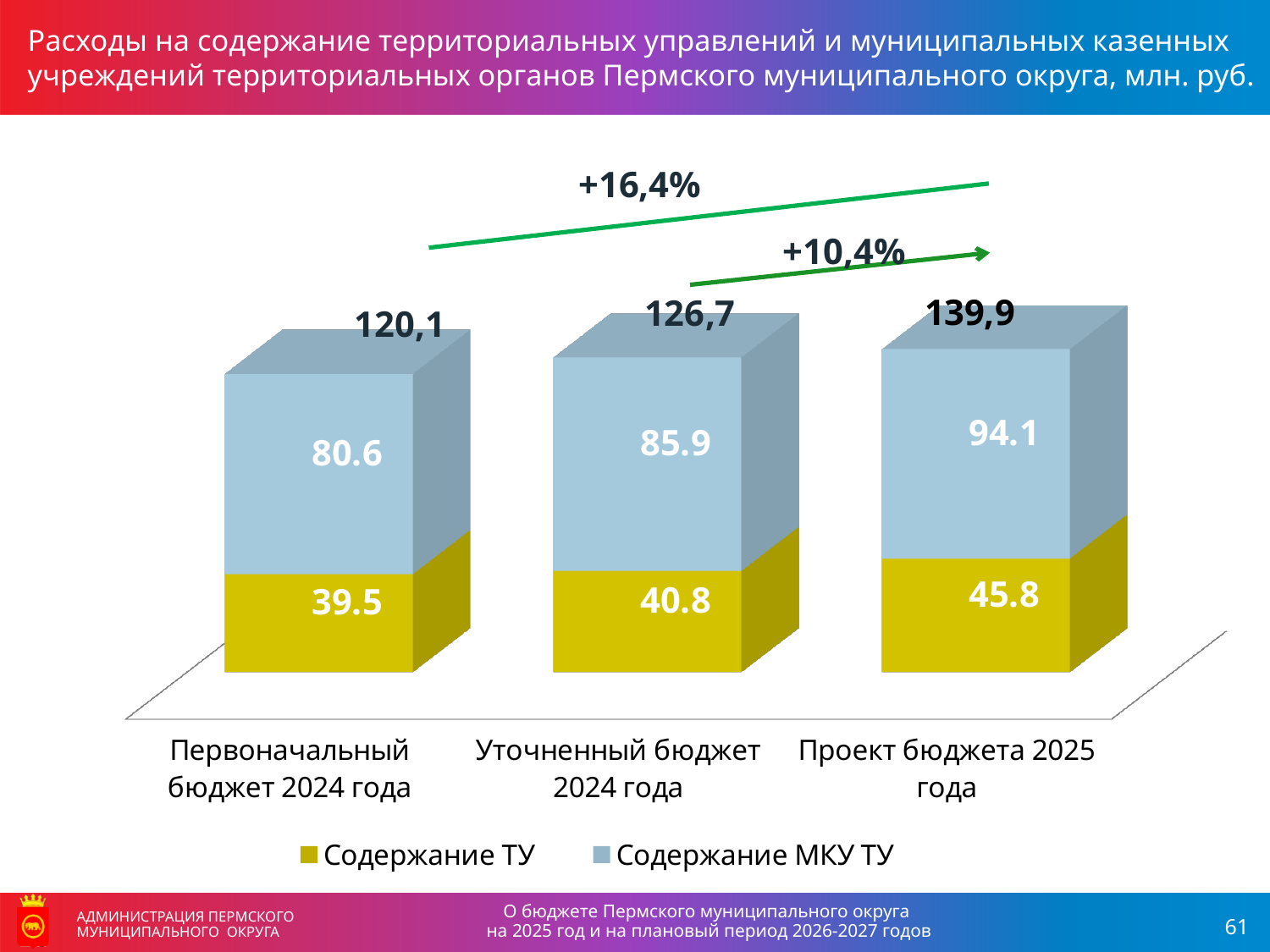
What is the value of Содержание МКУ ТУ for Уточненный бюджет 2024 года? 85.9 How many categories are shown on the x axis? 3 How many series does the legend list? 2 Which category has the lowest value for Содержание МКУ ТУ? Первоначальный бюджет 2024 года Which is larger: Содержание ТУ for Уточненный бюджет 2024 года or Содержание ТУ for Проект бюджета 2025 года? Проект бюджета 2025 года What is the difference between Содержание МКУ ТУ for Проект бюджета 2025 года and for Уточненный бюджет 2024 года? 8.2 Which category has the highest value for Содержание ТУ? Проект бюджета 2025 года What is the total shown above the bar for Проект бюджета 2025 года? 139,9 What kind of chart is shown on the slide? Stacked bar chart What is the total shown above the bar for Первоначальный бюджет 2024 года? 120,1 What is the value of Содержание МКУ ТУ for Проект бюджета 2025 года? 94.1 What is the value of Содержание ТУ for Первоначальный бюджет 2024 года? 39.5